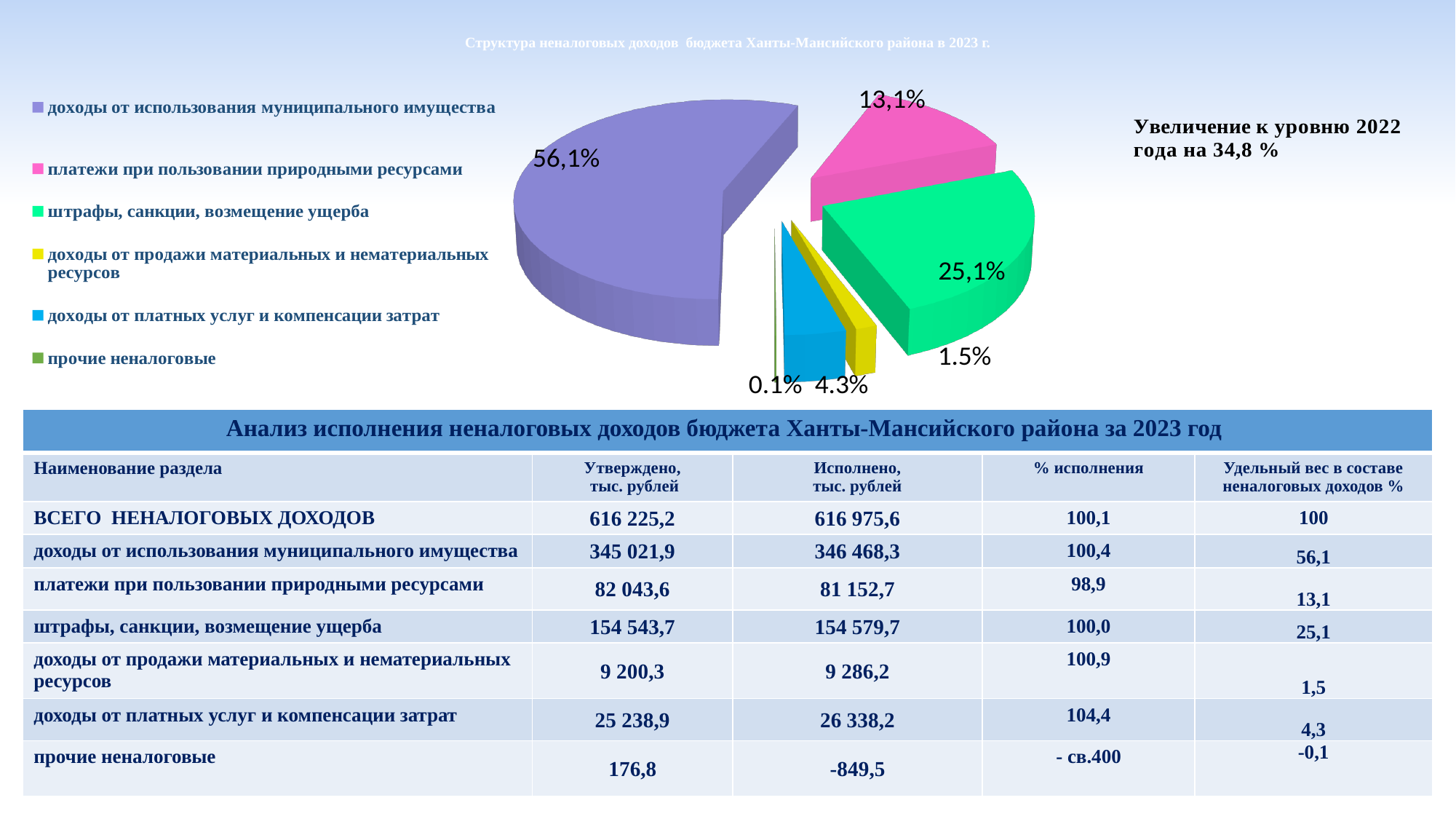
How many categories does the pie chart legend list? 6 What colour is the slice for "платежи при пользовании природными ресурсами"? pink What share of the pie does "доходы от платных услуг и компенсации затрат" have? 4.3% What share of the pie does "доходы от использования муниципального имущества" have? 56,1% Which category has the smallest slice of the pie? прочие неналоговые Which slice is larger: "штрафы, санкции, возмещение ущерба" or "платежи при пользовании природными ресурсами"? штрафы, санкции, возмещение ущерба What share of the pie does "платежи при пользовании природными ресурсами" have? 13,1% What share of the pie does "штрафы, санкции, возмещение ущерба" have? 25,1% What kind of chart is shown on the slide? pie chart What share of the pie does "доходы от продажи материальных и нематериальных ресурсов" have? 1.5% What is the difference in percentage points between the "доходы от использования муниципального имущества" slice and the "штрафы, санкции, возмещение ущерба" slice? 31 percentage points Which category has the largest slice of the pie? доходы от использования муниципального имущества